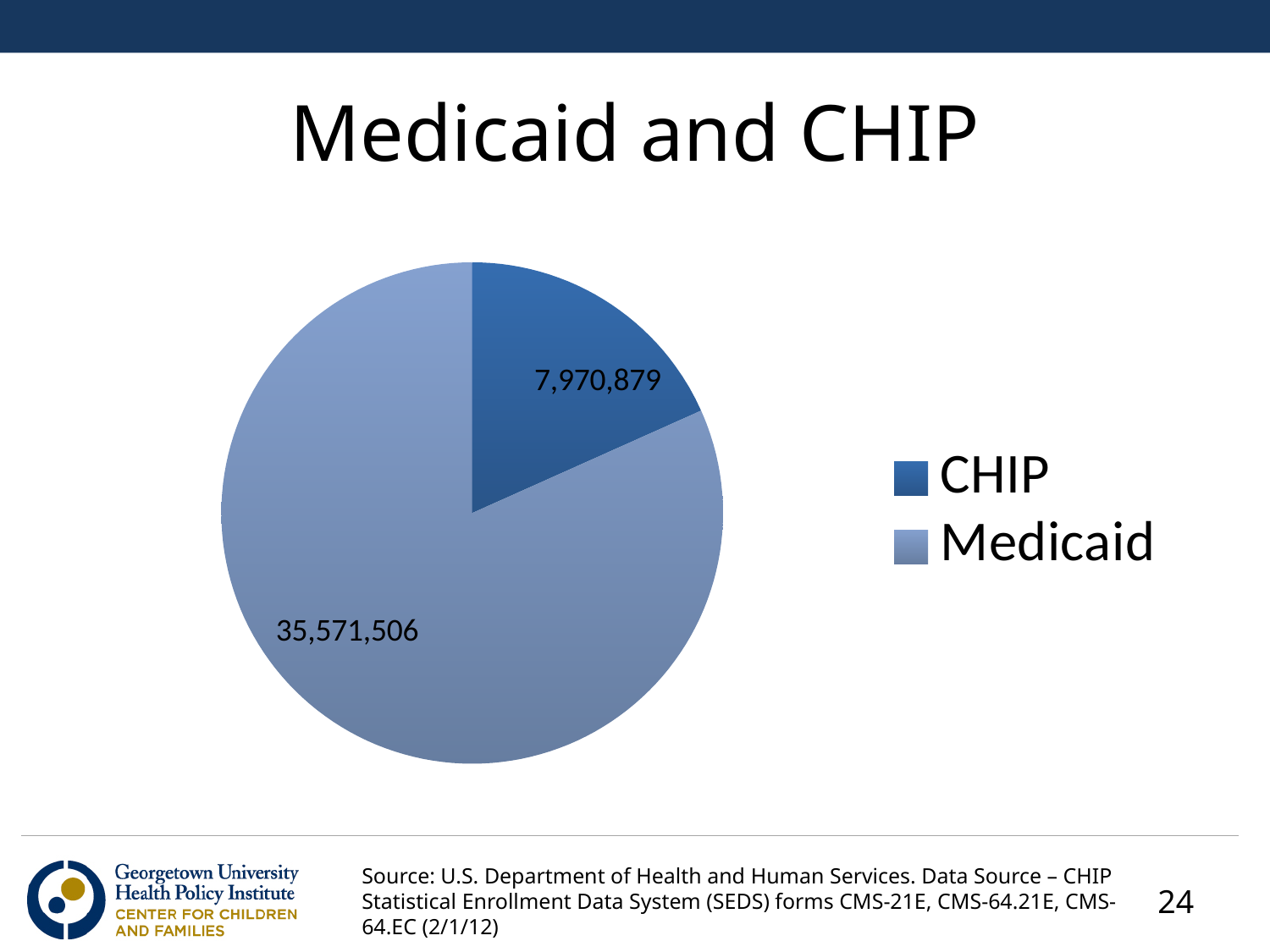
What is the difference between the Medicaid value and the CHIP value? 27,600,627 What is the title of the slide containing the pie chart? Medicaid and CHIP How many slices does the pie chart have? 2 What is the value shown for CHIP? 7,970,879 How many entries does the legend list? 2 What is the total of the two slices in the pie chart? 43,542,385 Which is larger, the value for Medicaid or the value for CHIP? Medicaid Which slice of the pie is the largest? Medicaid What type of chart is shown on the slide? Pie chart Which legend entry is shown in the darker blue colour? CHIP What is the value shown for Medicaid? 35,571,506 Which slice of the pie is the smallest? CHIP